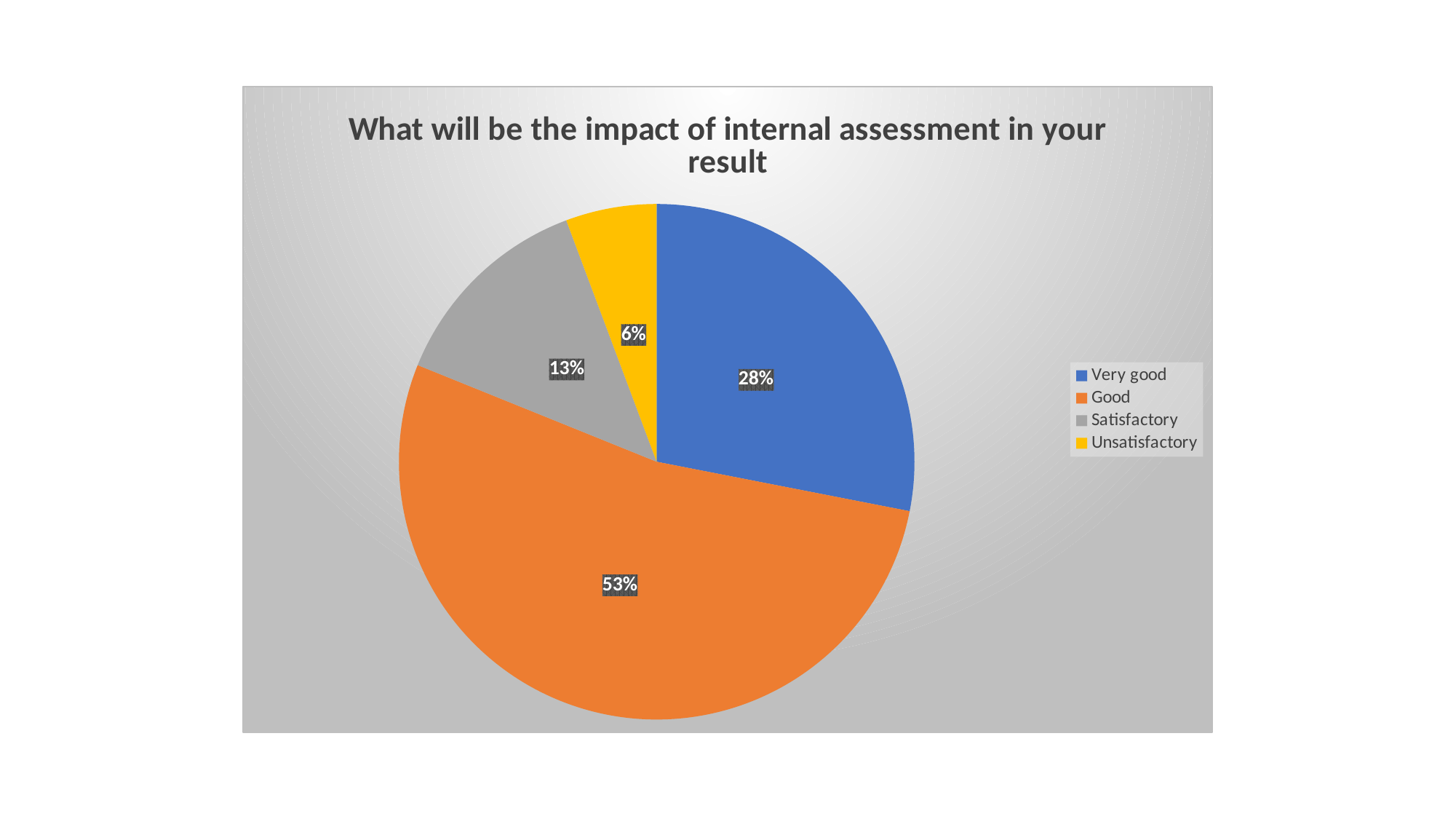
What is the title of the chart? What will be the impact of internal assessment in your result Which category has the largest slice of the pie? Good What is the value shown for Very good? 28% What colour is the Good slice in the pie chart? orange How many categories are shown in the pie chart? 4 What is the value shown for Satisfactory? 13% What is the value shown for Unsatisfactory? 6% Which is larger, the Satisfactory slice or the Unsatisfactory slice? Satisfactory What share of the pie does the Good slice represent? 53% Which category has the smallest slice of the pie? Unsatisfactory What kind of chart is shown on the slide? pie chart What is the difference between the Good and Very good percentages? 25%